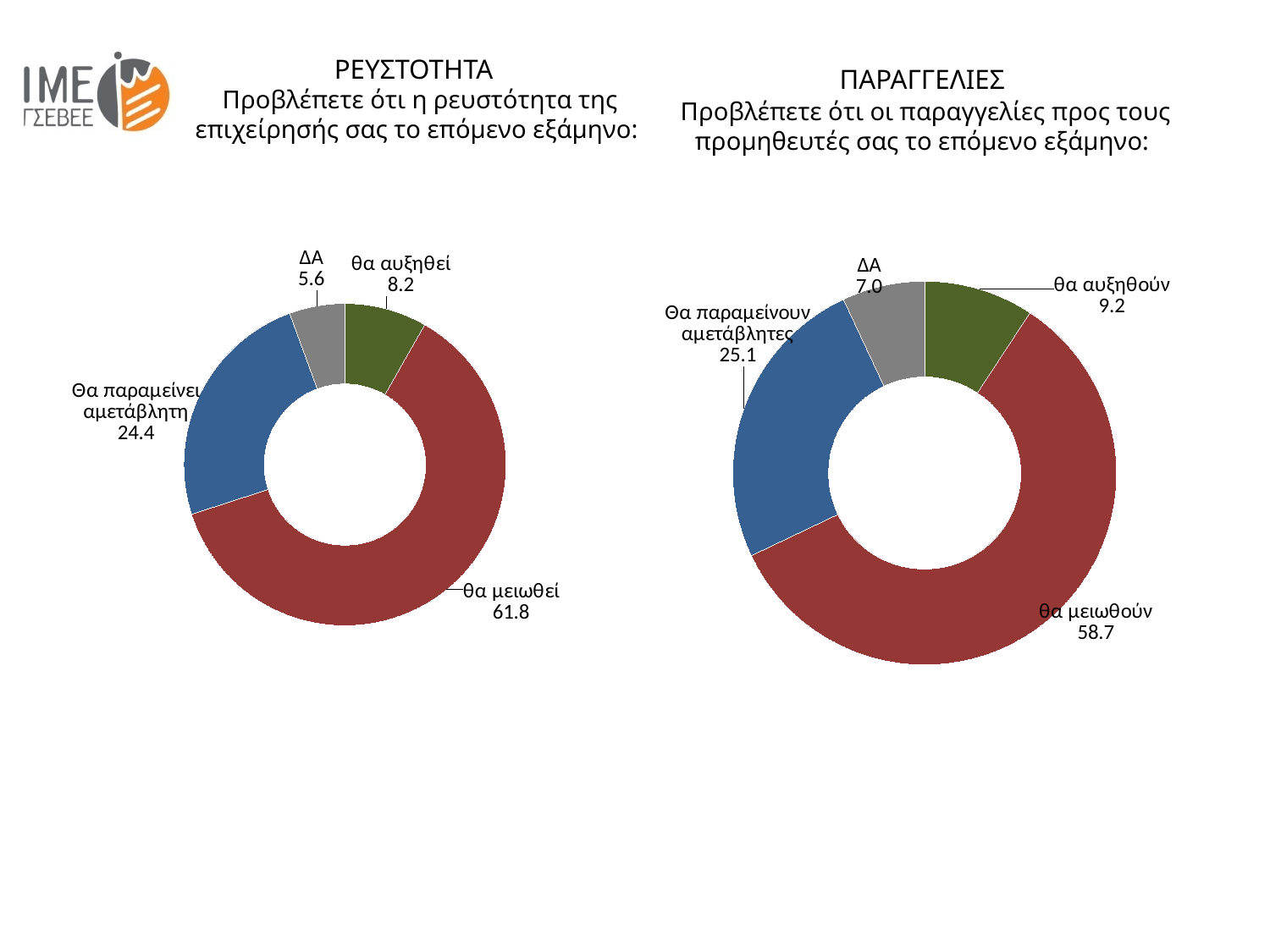
How many categories does the left chart (ΡΕΥΣΤΟΤΗΤΑ) show? 4 In the left chart (ΡΕΥΣΤΟΤΗΤΑ), what is the value for "Θα παραμείνει αμετάβλητη"? 24.4 In the left chart (ΡΕΥΣΤΟΤΗΤΑ), what is the difference between "θα μειωθεί" and "Θα παραμείνει αμετάβλητη"? 37.4 In the left chart (ΡΕΥΣΤΟΤΗΤΑ), what is the value for "θα μειωθεί"? 61.8 In the right chart (ΠΑΡΑΓΓΕΛΙΕΣ), what is the difference between "θα μειωθούν" and "θα αυξηθούν"? 49.5 In the right chart (ΠΑΡΑΓΓΕΛΙΕΣ), which category has the smallest value? ΔΑ What kind of chart is the right chart (ΠΑΡΑΓΓΕΛΙΕΣ)? Doughnut chart In the right chart (ΠΑΡΑΓΓΕΛΙΕΣ), what is the value for "θα αυξηθούν"? 9.2 In the right chart (ΠΑΡΑΓΓΕΛΙΕΣ), what is the value for "ΔΑ"? 7.0 In the right chart (ΠΑΡΑΓΓΕΛΙΕΣ), which is larger: "Θα παραμείνουν αμετάβλητες" or "ΔΑ"? Θα παραμείνουν αμετάβλητες In the left chart (ΡΕΥΣΤΟΤΗΤΑ), what colour is the "θα μειωθεί" segment? Red In the left chart (ΡΕΥΣΤΟΤΗΤΑ), which category has the largest value? θα μειωθεί